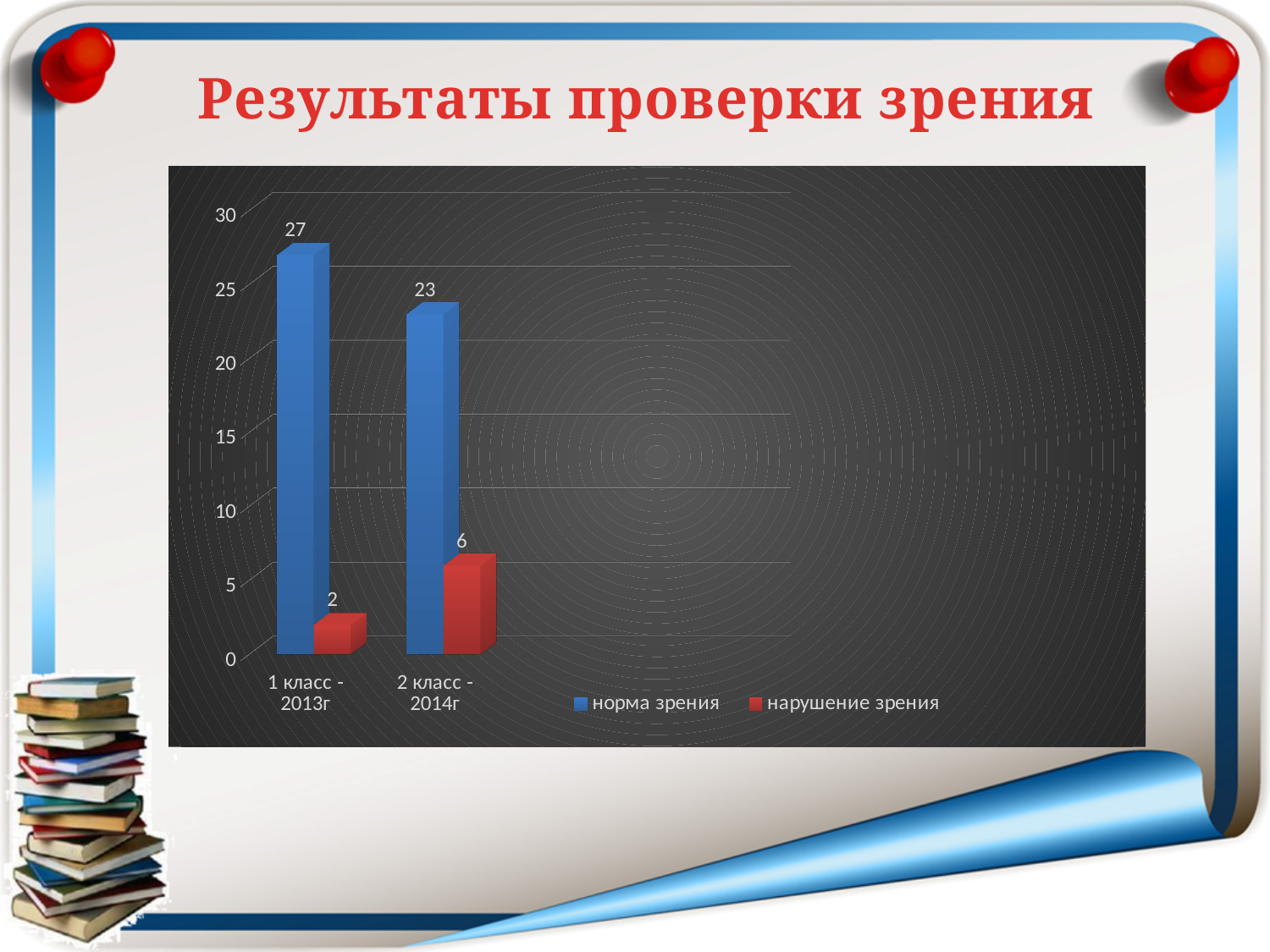
What kind of chart is shown on the slide? bar chart What is the value for норма зрения in 2 класс - 2014г? 23 What is the value for нарушение зрения in 2 класс - 2014г? 6 How many categories are shown on the x axis? 2 Which category has the highest value for норма зрения? 1 класс - 2013г What is the difference between нарушение зрения in 2 класс - 2014г and 1 класс - 2013г? 4 Which is larger: норма зрения in 2 класс - 2014г or нарушение зрения in 2 класс - 2014г? норма зрения in 2 класс - 2014г What is the value for норма зрения in 1 класс - 2013г? 27 What is the value for нарушение зрения in 1 класс - 2013г? 2 How many series does the legend list? 2 Which category has the lowest value for нарушение зрения? 1 класс - 2013г What is the difference between норма зрения in 1 класс - 2013г and 2 класс - 2014г? 4